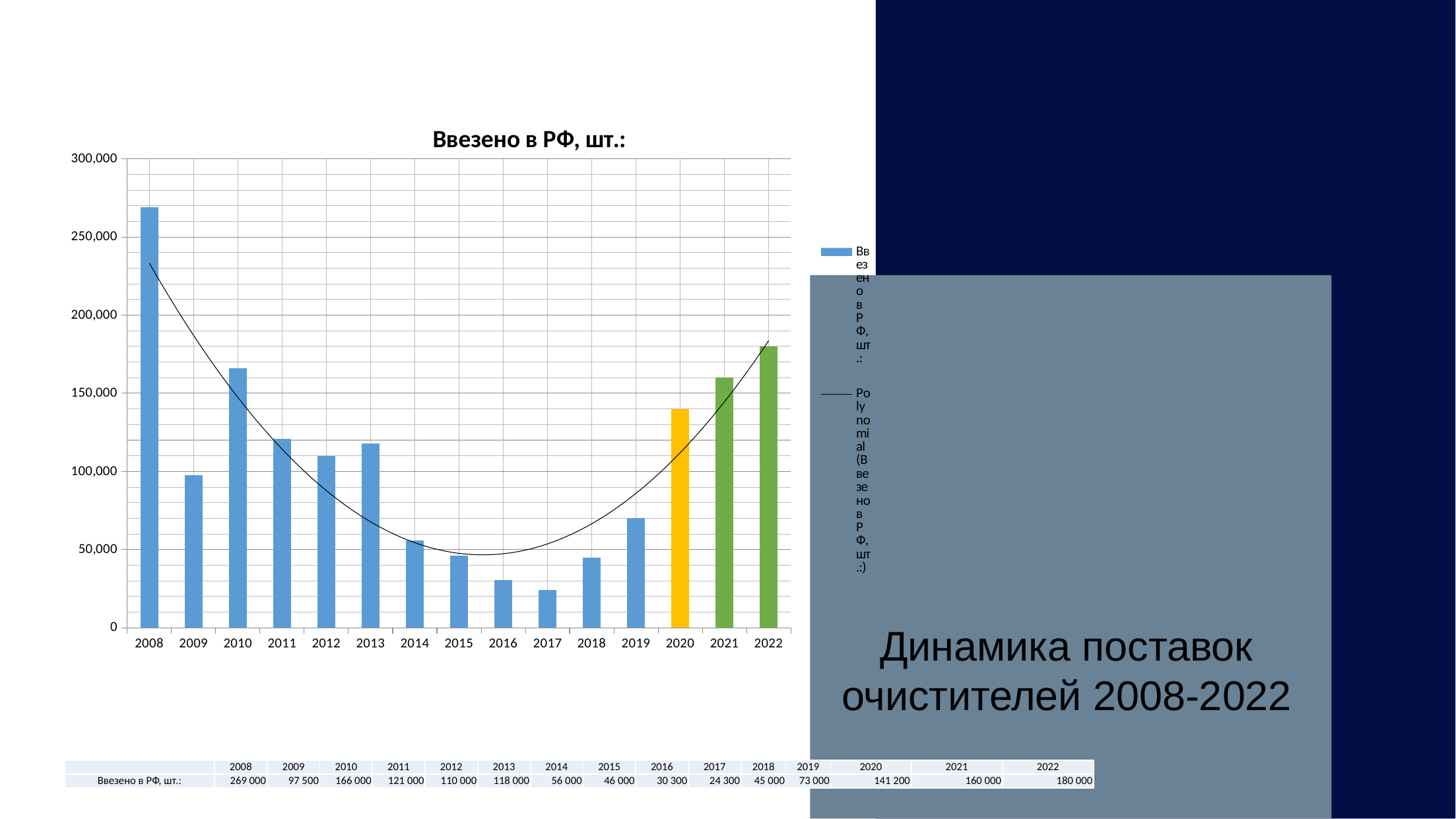
Which year has the highest value in the chart 'Ввезено в РФ, шт.:'? 2008 How many years are shown on the x axis of the chart 'Ввезено в РФ, шт.:'? 15 Which year has the lowest value in the chart 'Ввезено в РФ, шт.:'? 2017 What kind of chart is 'Ввезено в РФ, шт.:'? bar chart What is the value for 2020 in the chart 'Ввезено в РФ, шт.:'? 141 200 What is the value for 2017 in the chart 'Ввезено в РФ, шт.:'? 24 300 Is the value for 2019 in the chart 'Ввезено в РФ, шт.:' greater or less than 100,000? less What is the difference between the values for 2022 and 2021 in the chart 'Ввезено в РФ, шт.:'? 20 000 Which is larger in the chart 'Ввезено в РФ, шт.:': the value for 2010 or the value for 2011? 2010 What is the value for 2008 in the chart 'Ввезено в РФ, шт.:'? 269 000 Do the values in the chart 'Ввезено в РФ, шт.:' rise or fall from 2019 to 2022? rise How many entries does the legend of the chart 'Ввезено в РФ, шт.:' list? 2